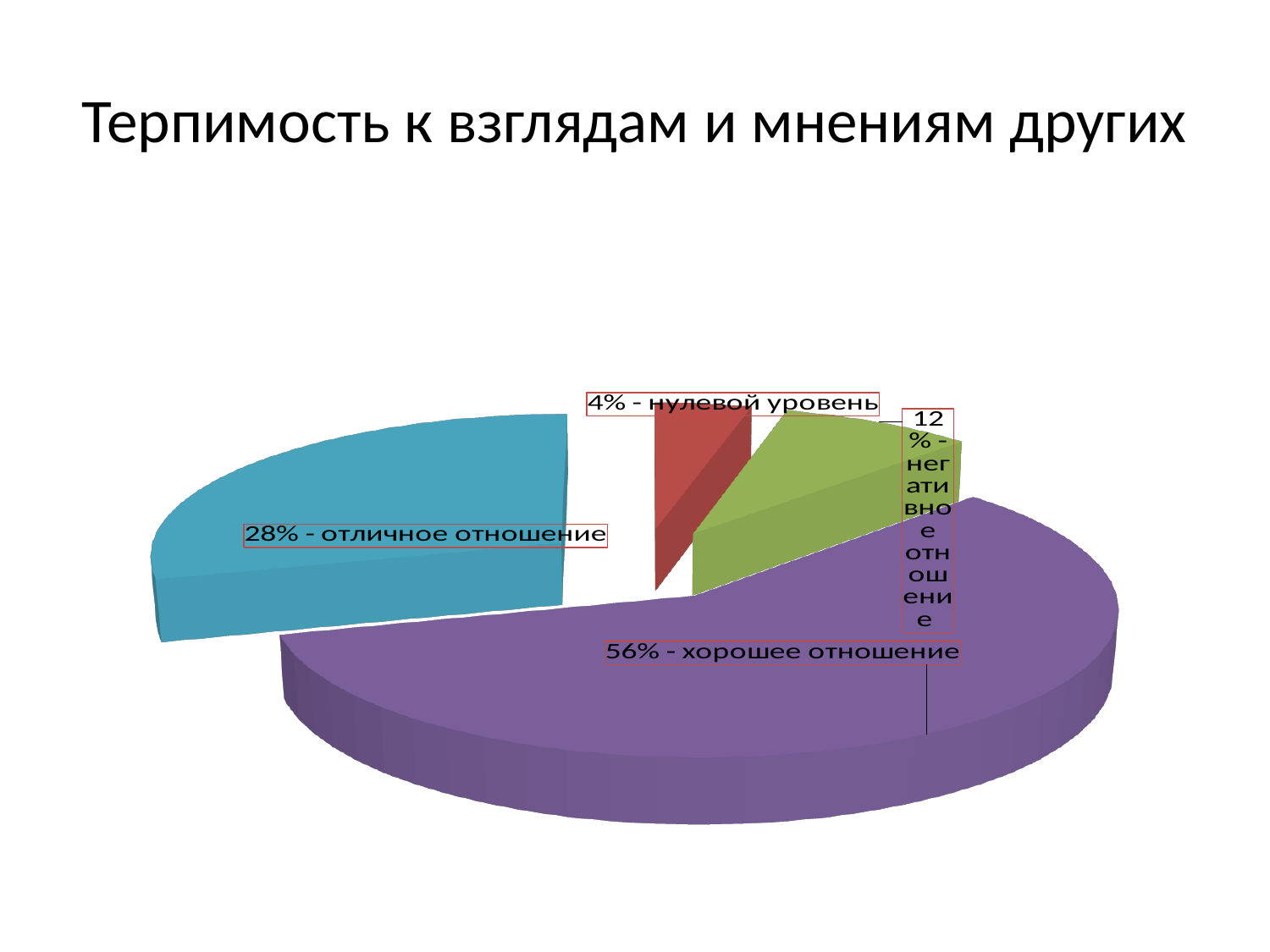
What share of the pie is labelled "отличное отношение"? 28% What is the difference between the shares for "хорошее отношение" and "отличное отношение"? 28% What share of the pie is labelled "негативное отношение"? 12% What share of the pie is labelled "нулевой уровень"? 4% Which category has the smallest share of the pie? нулевой уровень What is the slide title? Терпимость к взглядам и мнениям других How many slices does the pie chart have? 4 Which is larger: the share for "негативное отношение" or the share for "нулевой уровень"? негативное отношение What colour is the slice labelled "56% - хорошее отношение"? Purple What kind of chart is shown on the slide? Pie chart Which category has the largest share of the pie? хорошее отношение